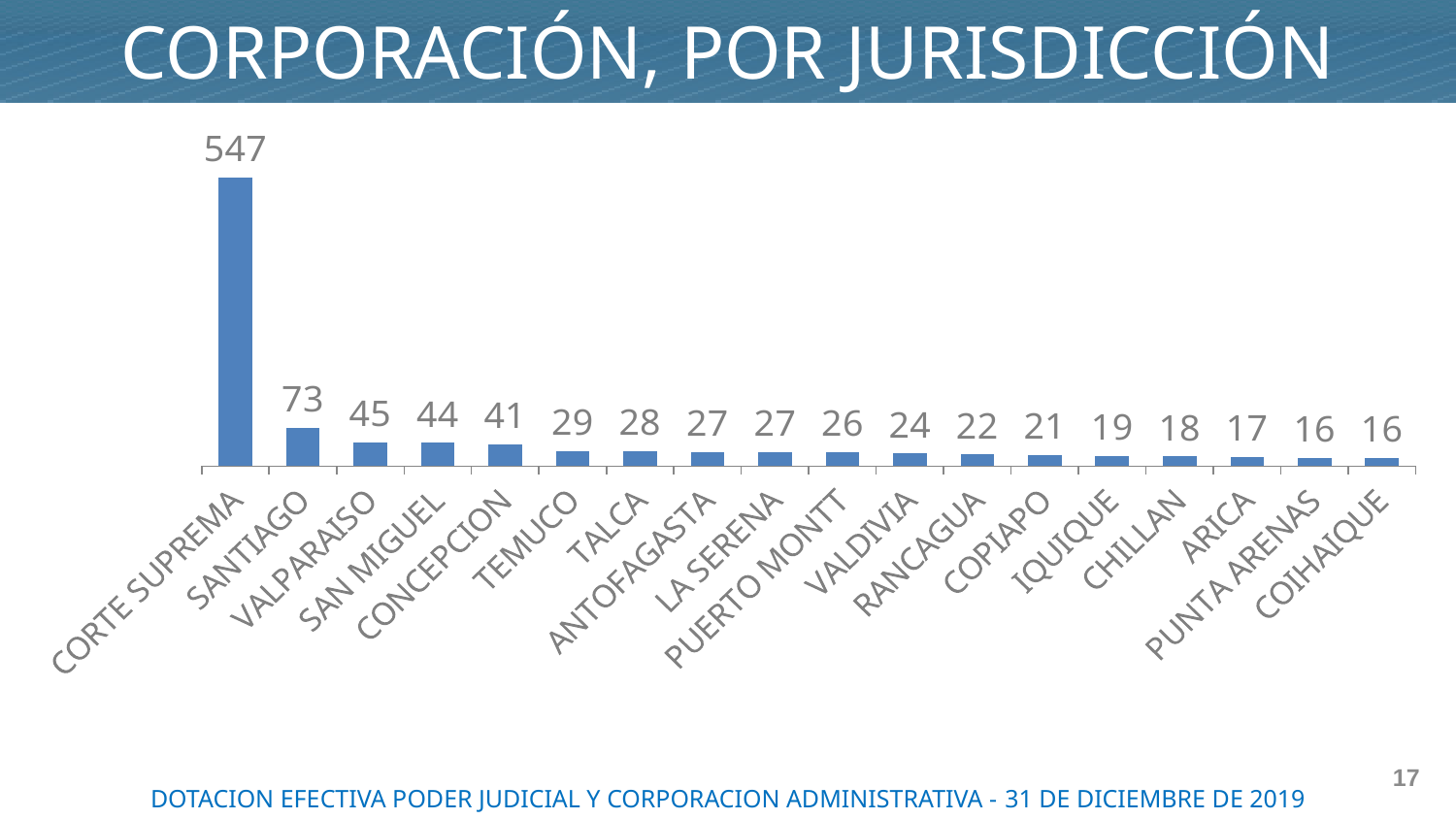
Do the values rise or fall from left to right along the x axis? Fall What is the value for CONCEPCION? 41 What is the value for CORTE SUPREMA? 547 How many jurisdictions are shown in the chart? 18 Which jurisdiction has the highest value? CORTE SUPREMA What is the value for SANTIAGO? 73 What is the difference between the values for CORTE SUPREMA and SANTIAGO? 474 What kind of chart is shown on the slide? Bar chart What is the difference between the values for VALPARAISO and TEMUCO? 16 What is the value for IQUIQUE? 19 What is the value for PUERTO MONTT? 26 Which has a larger value, SAN MIGUEL or VALDIVIA? SAN MIGUEL